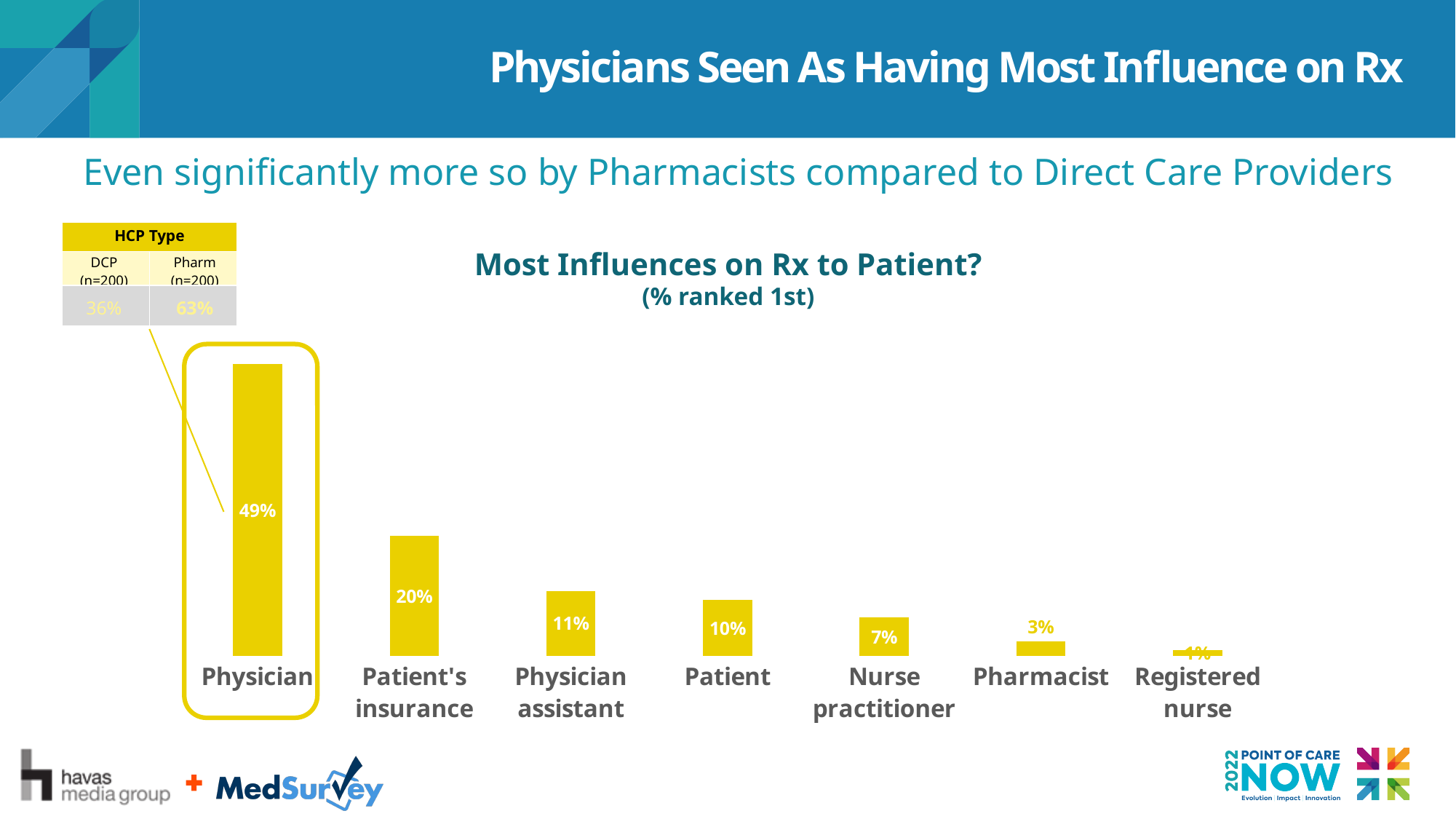
What is the value shown for Nurse practitioner? 7% Which category has the highest value in the chart? Physician What is the value shown for Patient's insurance? 20% Which category has the lowest value in the chart? Registered nurse What is the difference between the values for Physician and Patient's insurance? 29% In the HCP Type callout table, what percentage of Pharm respondents ranked Physician 1st? 63% What type of chart is shown on the slide? Bar chart How many categories are shown in the chart? 7 What is the value shown for Pharmacist? 3% Which is larger, the value for Physician assistant or the value for Patient? Physician assistant Do the values rise or fall moving from left to right across the categories? Fall What percentage ranked Physician 1st as the most influence on Rx to patient? 49%